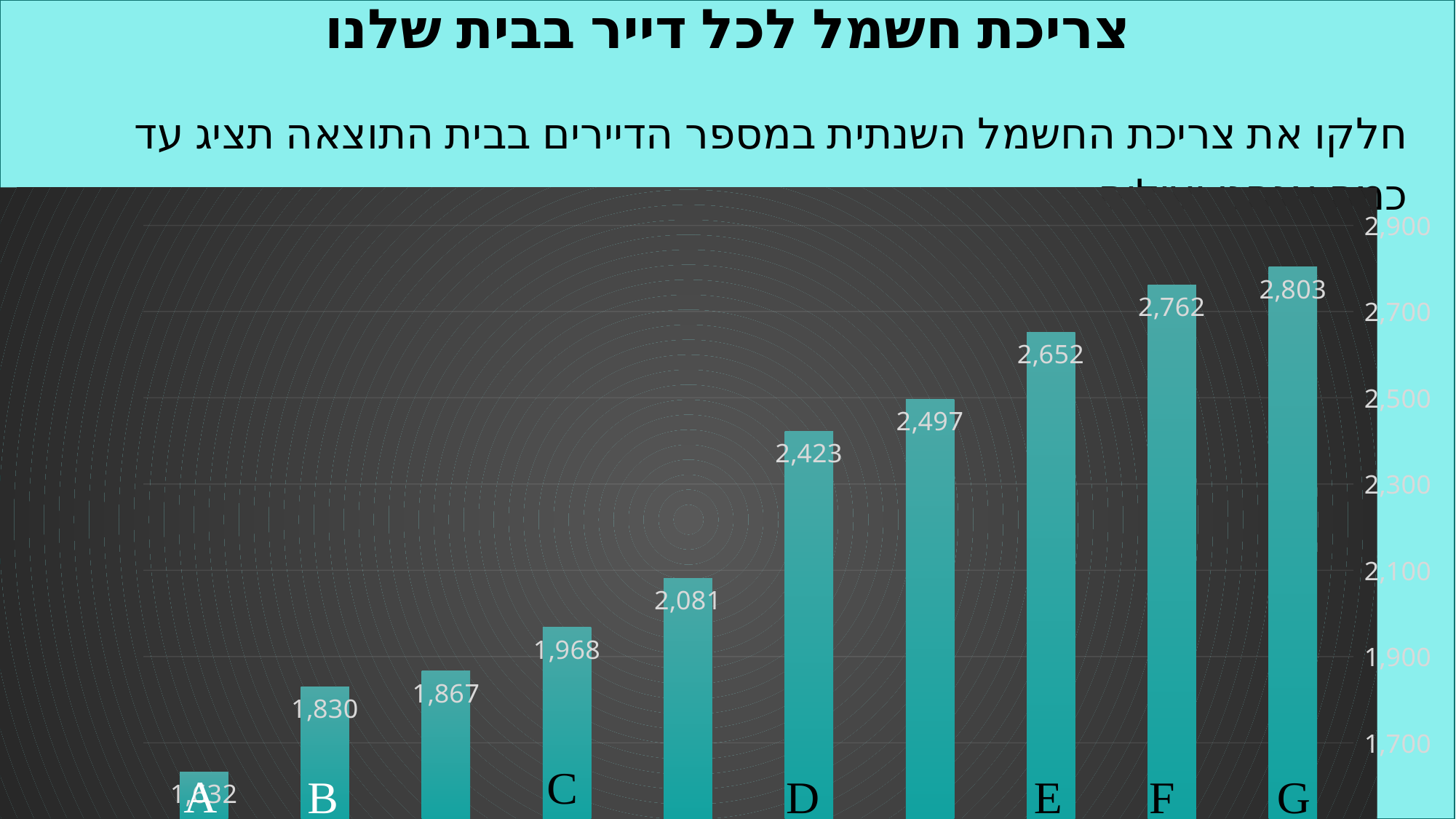
What is the difference between the bar labelled G and the bar labelled F? 41 What is the value of the bar labelled E? 2,652 How many bars are plotted in the chart? 10 What is the value of the bar labelled F? 2,762 What is the value of the bar labelled C? 1,968 What kind of chart is shown on the slide? bar chart What is the difference between the bar labelled F and the bar labelled E? 110 Which is larger, the bar labelled B or the bar labelled F? F Is the value of the bar labelled D greater or less than 2,300? greater What is the value of the bar labelled B? 1,830 Do the bar values rise or fall from left to right across the chart? rise What is the value of the tallest bar in the chart? 2,803